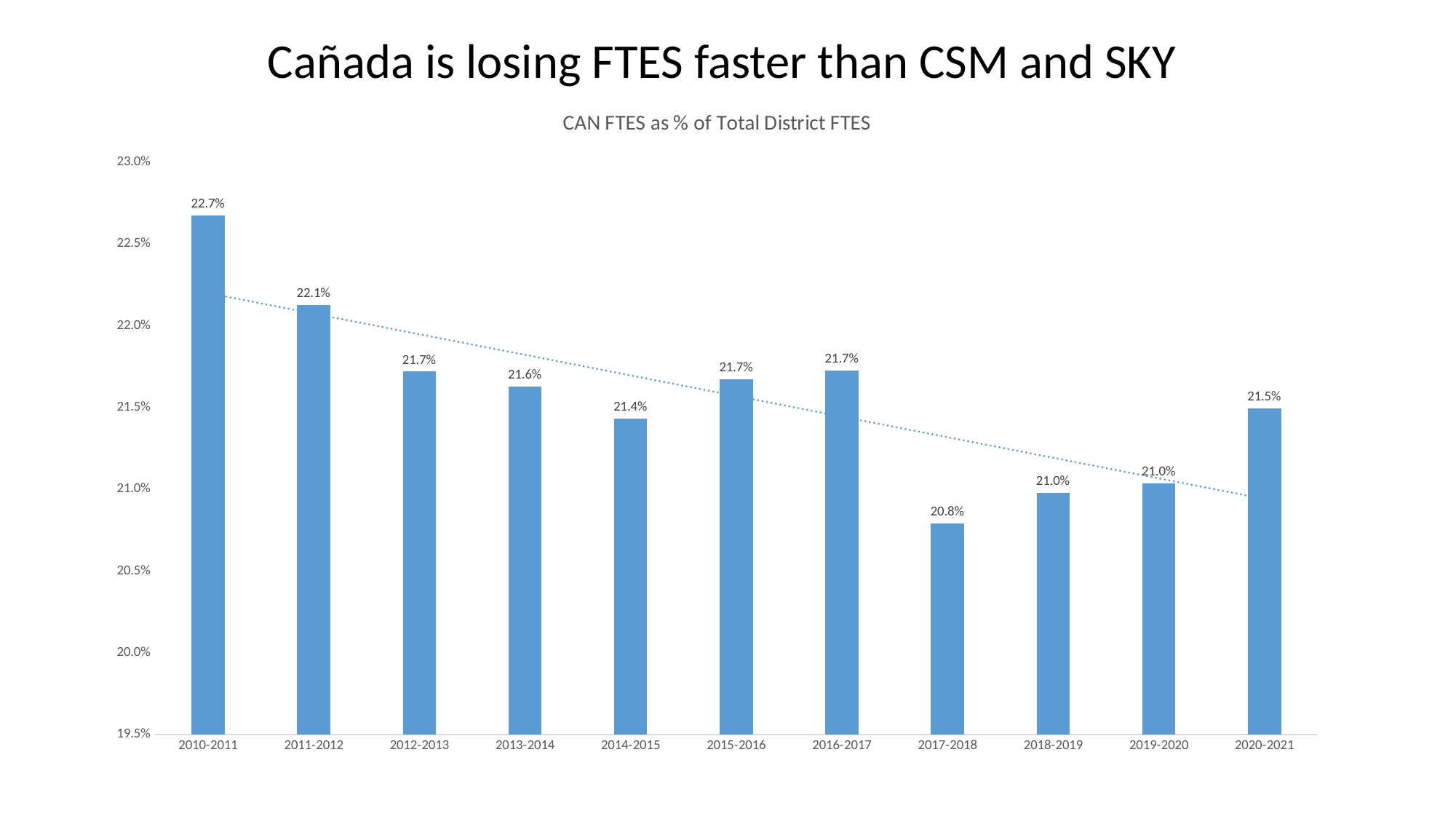
Is the value for 2018-2019 greater or less than 21.5%? less What is the value shown for 2017-2018? 20.8% Which year has the lowest CAN FTES as % of Total District FTES? 2017-2018 What is the difference between the values for 2010-2011 and 2017-2018? 1.9% What kind of chart is shown on the slide? bar chart Do the values generally rise or fall from 2010-2011 to 2019-2020? fall How many years are shown on the x axis? 11 Which is larger, the value for 2011-2012 or the value for 2014-2015? 2011-2012 Which year has the highest CAN FTES as % of Total District FTES? 2010-2011 What is the CAN FTES as % of Total District FTES for 2010-2011? 22.7% What is the title of the chart? CAN FTES as % of Total District FTES What is the value shown for 2020-2021? 21.5%